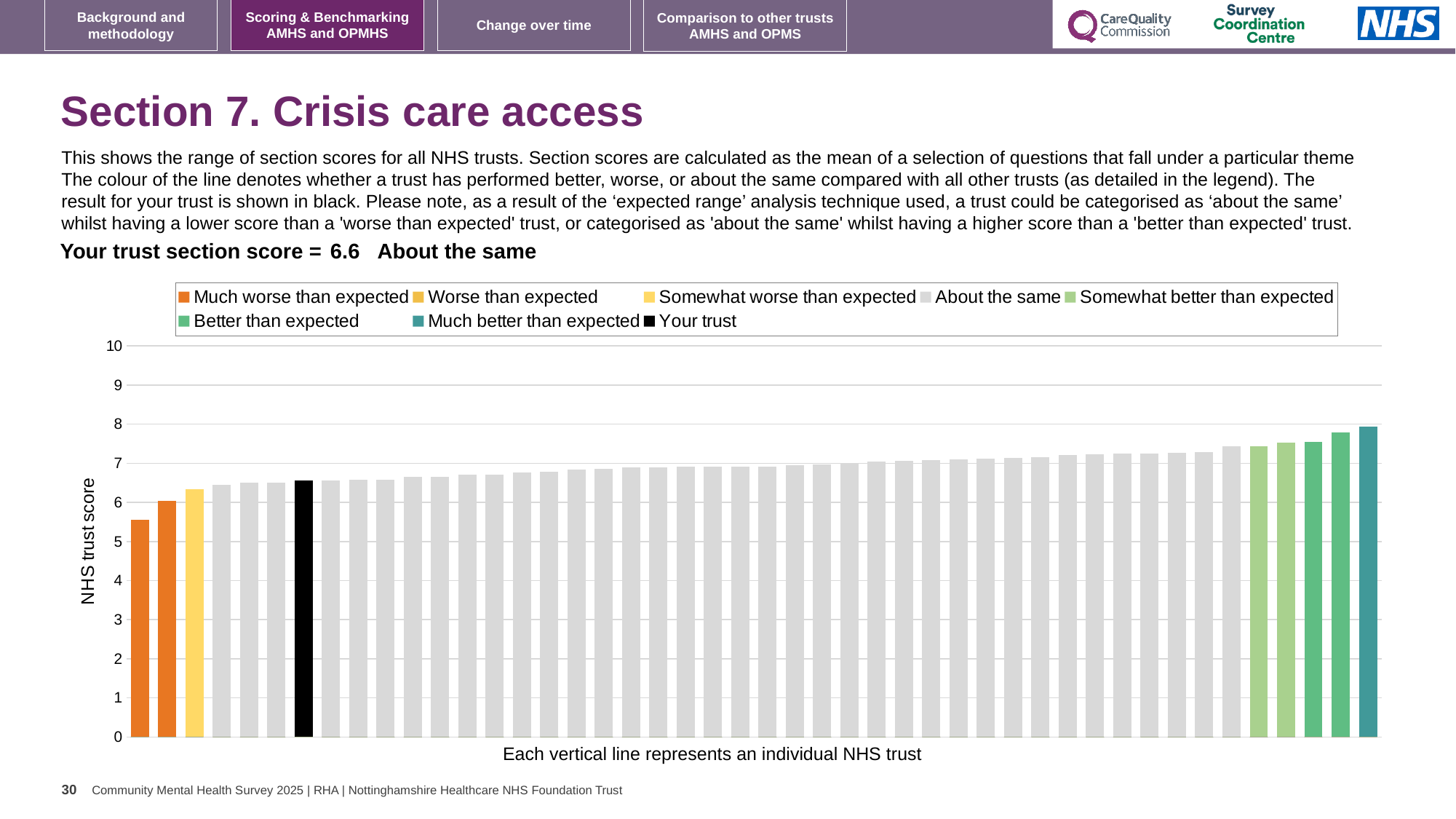
How many entries does the chart legend list? 8 How many bars are coloured orange ('Much worse than expected')? 2 What is the section score for your trust shown on the slide? 6.6 Is the value of the rightmost (highest) bar greater or less than 7? greater Is the value of the leftmost (lowest) bar greater or less than 6? less Do the bar values rise or fall from left to right along the x axis? rise Is the value of the black 'Your trust' bar greater or less than 7? less What kind of chart is shown on the slide? bar chart Which legend category does the tallest bar belong to? Much better than expected What is the label on the vertical axis of the chart? NHS trust score What colour is used for the 'Your trust' bar in the legend? black